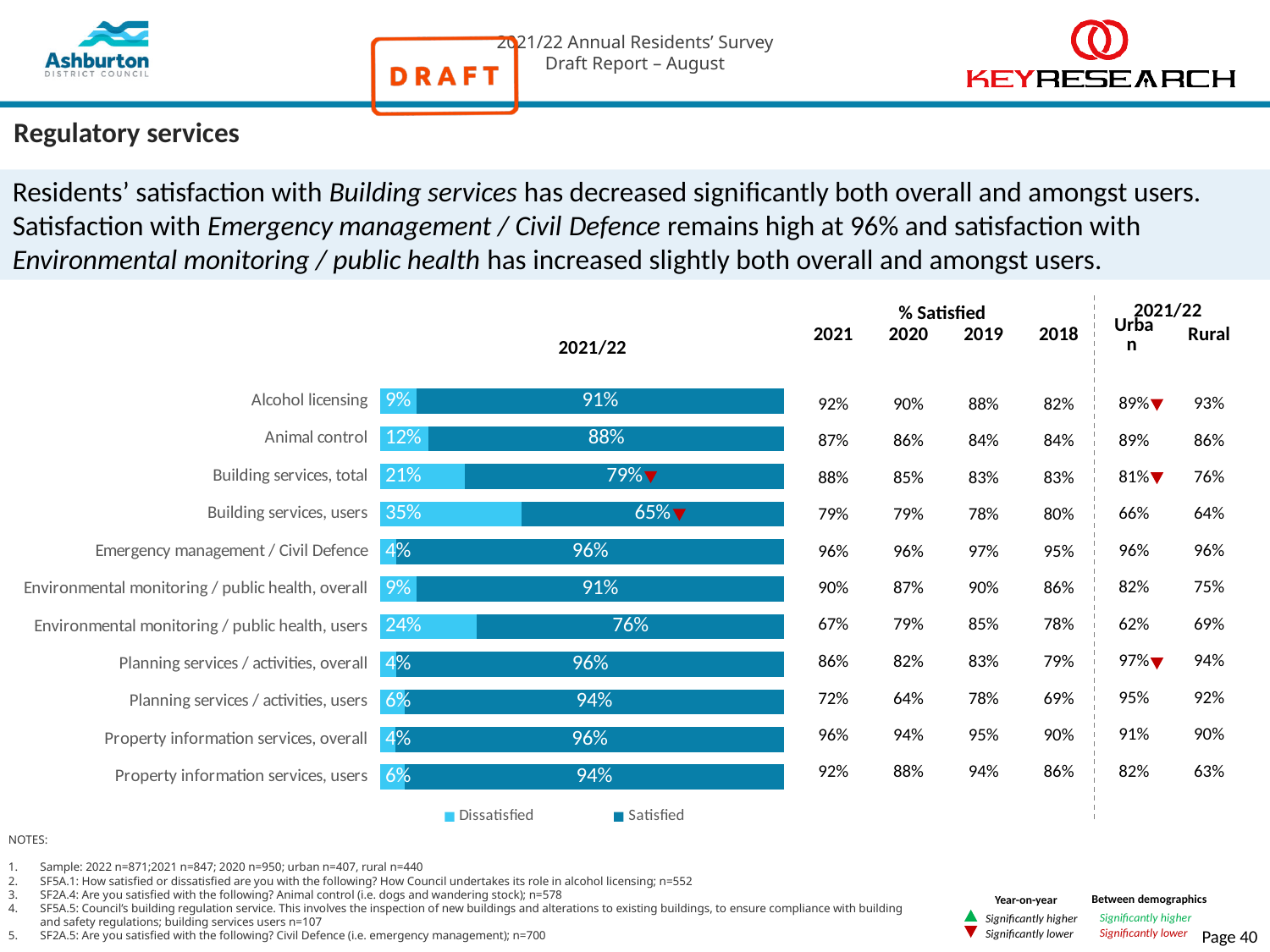
What is the Satisfied value for Environmental monitoring / public health, users in the 2021/22 chart? 76% What is the Satisfied value for Alcohol licensing in the 2021/22 chart? 91% How many series does the chart legend list? 2 Which has a higher Satisfied value in the 2021/22 chart, Alcohol licensing or Animal control? Alcohol licensing Which category has the lowest Satisfied value in the 2021/22 chart? Building services, users What is the Dissatisfied value for Building services, users in the 2021/22 chart? 35% What are the two legend entries of the chart? Dissatisfied and Satisfied What is the difference between the Satisfied values for Building services, total and Building services, users in the 2021/22 chart? 14 percentage points What is the total of the Dissatisfied and Satisfied segments for Animal control in the 2021/22 chart? 100% How many categories are plotted in the 2021/22 chart? 11 What type of chart is shown on the slide? Stacked bar chart Which category has the highest Dissatisfied value in the 2021/22 chart? Building services, users